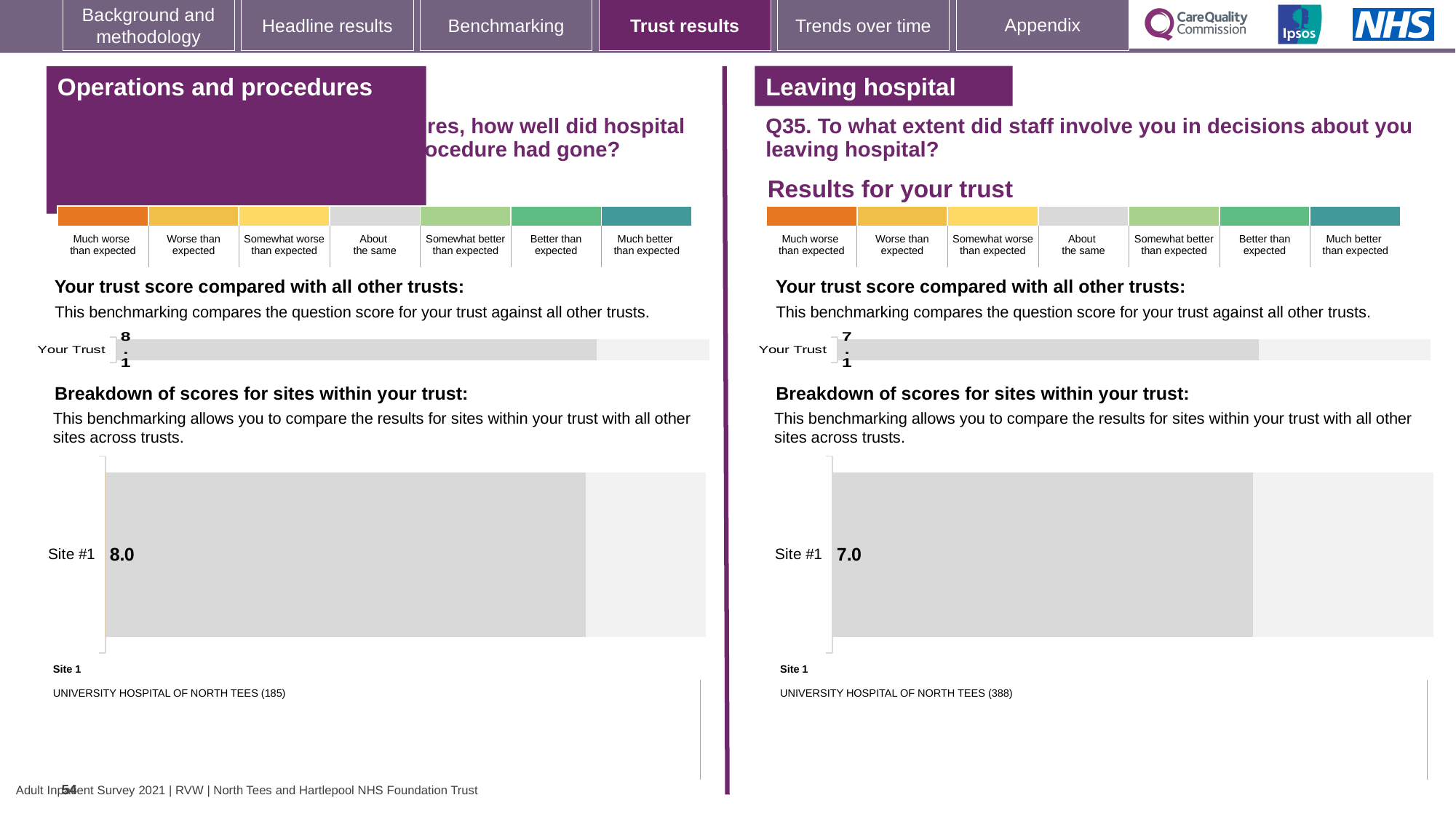
Which question is shown in the Leaving hospital section? Q35. To what extent did staff involve you in decisions about you leaving hospital? In the Operations and procedures section, what is the score shown for Your Trust in the trust comparison chart? 8.1 What is the difference between the Site #1 score in the Operations and procedures section and the Site #1 score in the Leaving hospital section? 1.0 In the Leaving hospital section, what is the score shown for Your Trust in the trust comparison chart? 7.1 How many sites are shown in the site breakdown chart in the Operations and procedures section? 1 In the Operations and procedures section, what is the score shown for Site #1 in the site breakdown chart? 8.0 Which site is labelled as Site 1 in the Leaving hospital section's site breakdown? UNIVERSITY HOSPITAL OF NORTH TEES (388) Which is larger: the Your Trust score in the Operations and procedures section or the Your Trust score in the Leaving hospital section? Operations and procedures In the Leaving hospital section, what is the score shown for Site #1 in the site breakdown chart? 7.0 What kind of chart is used to show the Site #1 score in the Leaving hospital section? bar chart In the Leaving hospital section, what is the difference between the Your Trust score and the Site #1 score? 0.1